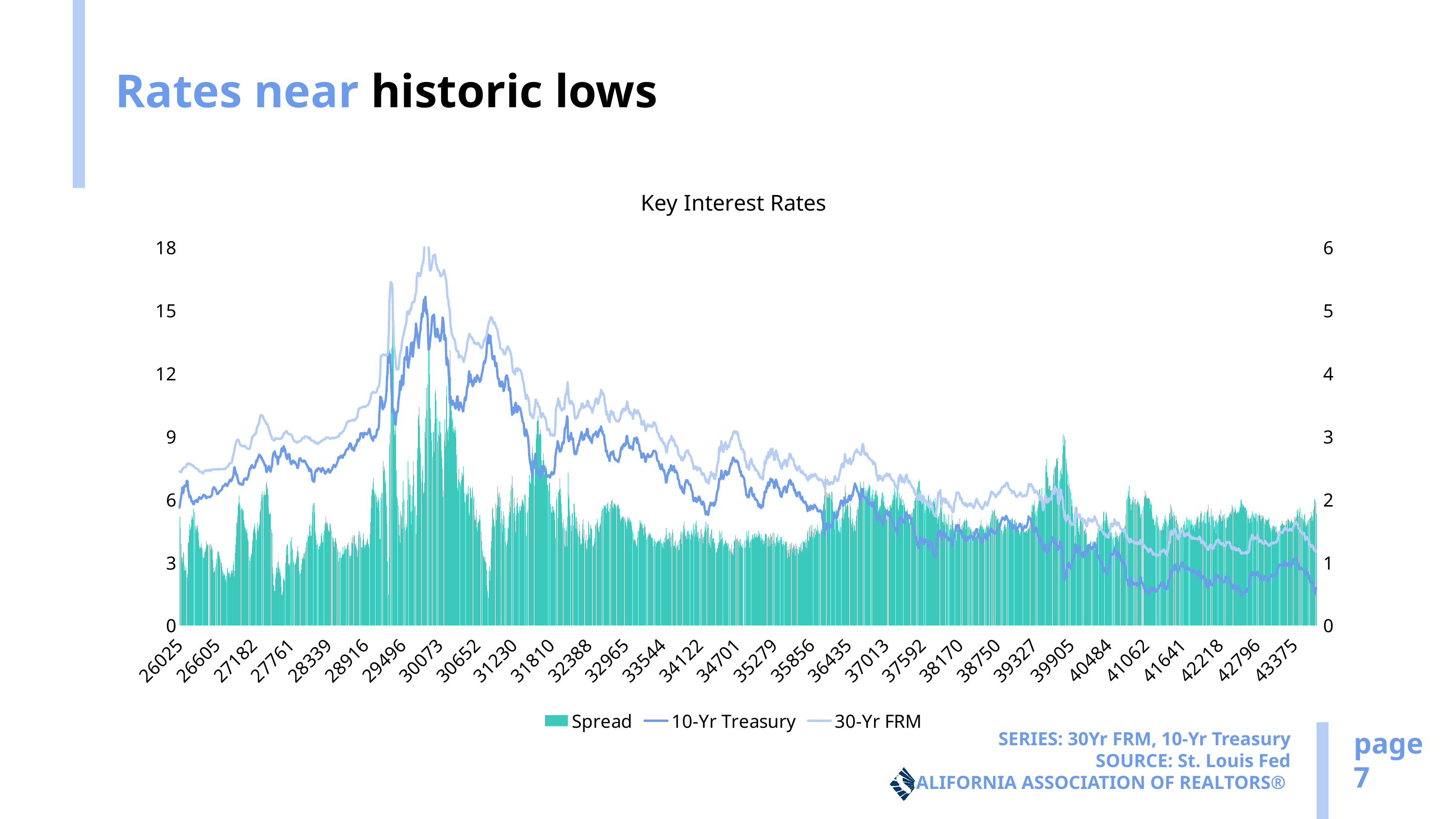
Does the 30-Yr FRM line rise or fall from its peak near 30073 to the right end of the chart? Fall How many series does the chart legend list? 3 Which series reaches the highest point on the chart? 30-Yr FRM What kind of chart is shown on the slide? Combined bar and line chart At the far right end of the chart, which line is higher: 30-Yr FRM or 10-Yr Treasury? 30-Yr FRM What is the maximum value shown on the right vertical axis? 6 Is the peak of the 30-Yr FRM line greater or less than 12 on the left axis? greater Does the 10-Yr Treasury line end higher or lower at the right edge of the chart than it starts at the left edge? Lower What is the title of the chart? Key Interest Rates What is the maximum value shown on the left vertical axis? 18 At the far right end of the chart, is the 10-Yr Treasury line greater or less than 6 on the left axis? less Which series is plotted as bars rather than a line? Spread